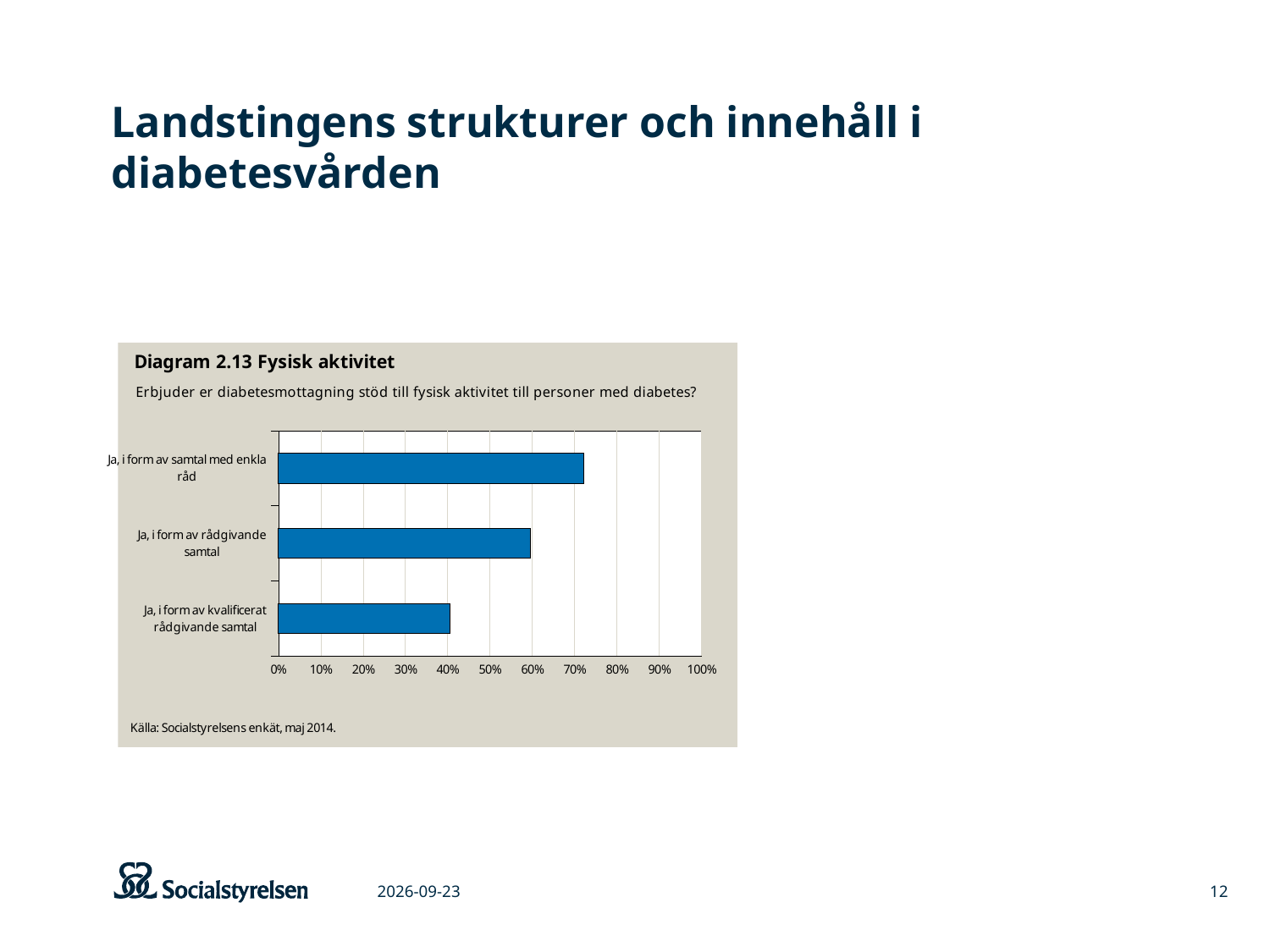
Is the value for 'Ja, i form av rådgivande samtal' greater or less than 70%? less Which is larger: the value for 'Ja, i form av rådgivande samtal' or for 'Ja, i form av kvalificerat rådgivande samtal'? Ja, i form av rådgivande samtal What kind of chart is shown on the slide? Bar chart Is the value for 'Ja, i form av kvalificerat rådgivande samtal' greater or less than 50%? less What is the title of the diagram? Diagram 2.13 Fysisk aktivitet Which is larger: the value for 'Ja, i form av samtal med enkla råd' or for 'Ja, i form av kvalificerat rådgivande samtal'? Ja, i form av samtal med enkla råd How many categories are plotted in the chart? 3 What source is cited below the chart? Socialstyrelsens enkät, maj 2014 Is the value for 'Ja, i form av kvalificerat rådgivande samtal' greater or less than 30%? greater Which category has the highest value? Ja, i form av samtal med enkla råd Which category has the lowest value? Ja, i form av kvalificerat rådgivande samtal